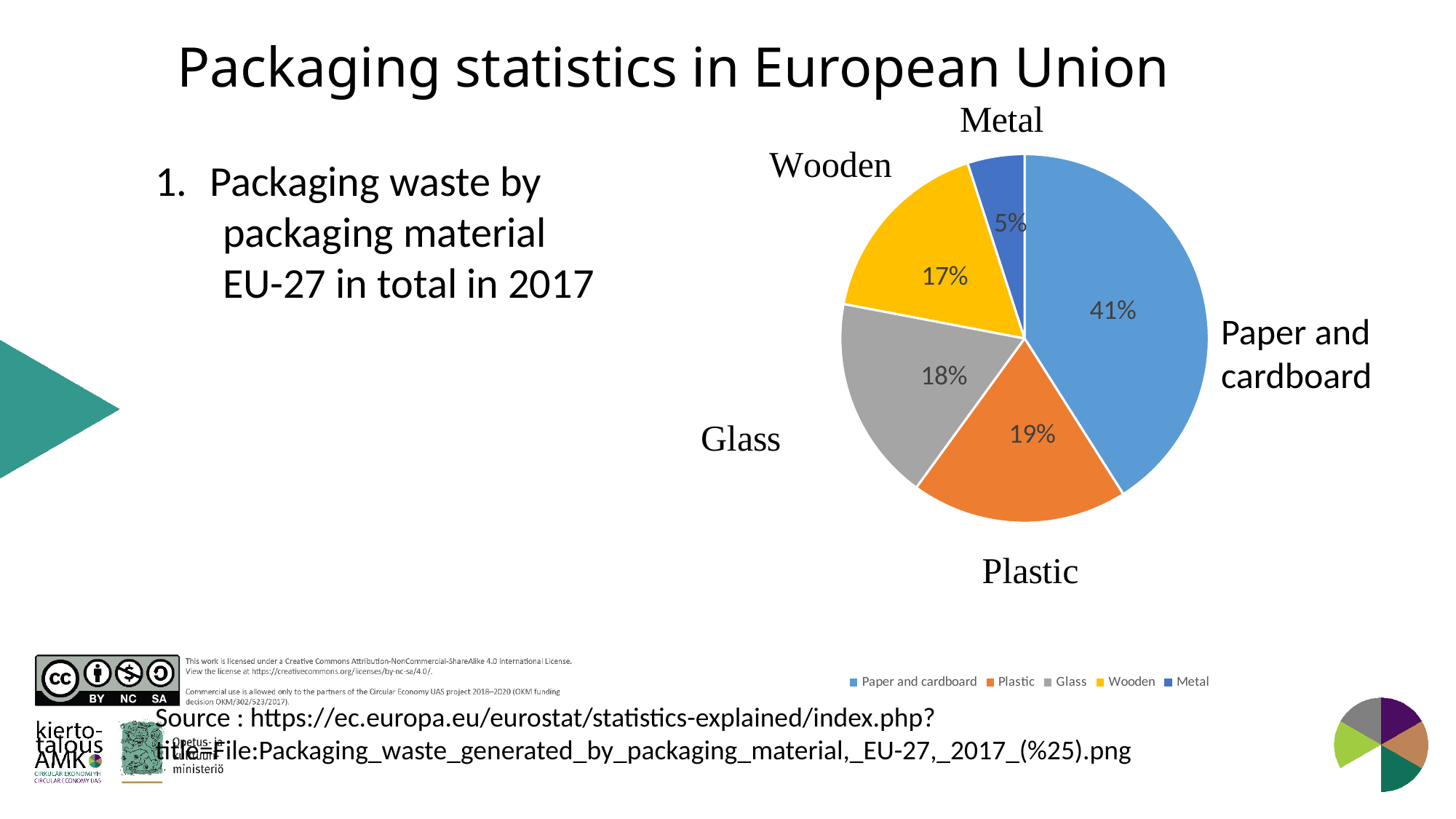
Which has a larger share, Wooden or Metal? Wooden What share of packaging waste is Wooden? 17% What share of packaging waste is Paper and cardboard? 41% Which packaging material has the largest share of the pie? Paper and cardboard What share of packaging waste is Plastic? 19% What share of packaging waste is Glass? 18% How many packaging material categories are shown in the pie chart? 5 What type of chart is shown on the slide? Pie chart What share of packaging waste is Metal? 5% What colour is the Glass slice in the pie chart? Grey What is the difference in percentage points between Paper and cardboard and Plastic? 22 Which packaging material has the smallest share of the pie? Metal